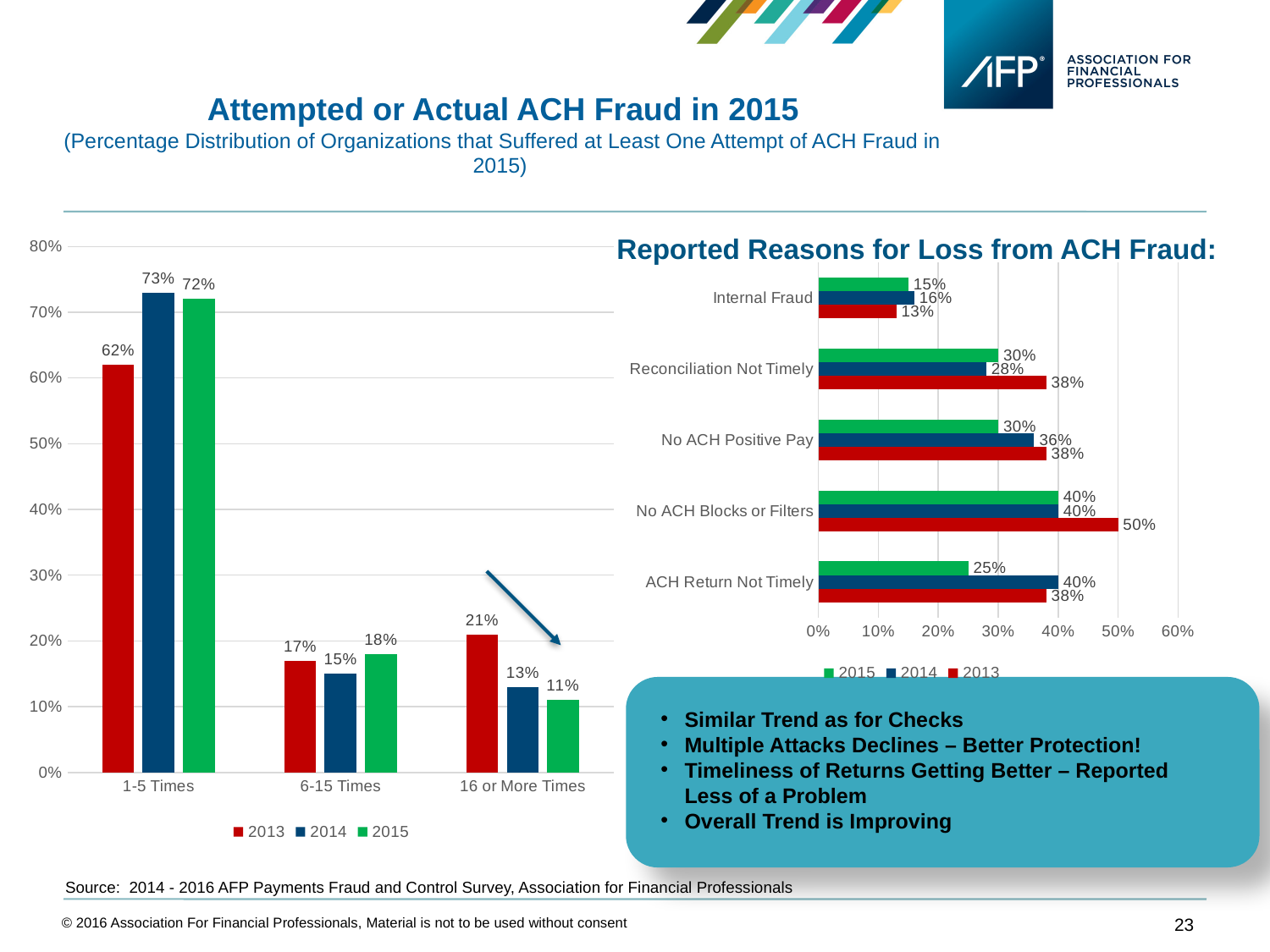
In the left chart (Attempted or Actual ACH Fraud in 2015), what is the 2015 value for 16 or More Times? 11% In the left chart (Attempted or Actual ACH Fraud in 2015), which category has the highest 2013 value? 1-5 Times In the right chart (Reported Reasons for Loss from ACH Fraud), which is larger for Reconciliation Not Timely: the 2014 value or the 2013 value? 2013 In the right chart (Reported Reasons for Loss from ACH Fraud), what is the 2013 value for No ACH Blocks or Filters? 50% In the right chart (Reported Reasons for Loss from ACH Fraud), which reason has the lowest 2013 value? Internal Fraud What kind of chart is the right chart (Reported Reasons for Loss from ACH Fraud)? Bar chart In the right chart (Reported Reasons for Loss from ACH Fraud), what is the 2015 value for ACH Return Not Timely? 25% In the left chart (Attempted or Actual ACH Fraud in 2015), what is the 2014 value for 1-5 Times? 73% In the left chart (Attempted or Actual ACH Fraud in 2015), how many categories are shown on the x axis? 3 In the right chart (Reported Reasons for Loss from ACH Fraud), what is the difference between the 2014 and 2015 values for ACH Return Not Timely? 15% In the left chart (Attempted or Actual ACH Fraud in 2015), how many series does the legend list? 3 In the left chart (Attempted or Actual ACH Fraud in 2015), what is the difference between the 2013 and 2015 values for 16 or More Times? 10%